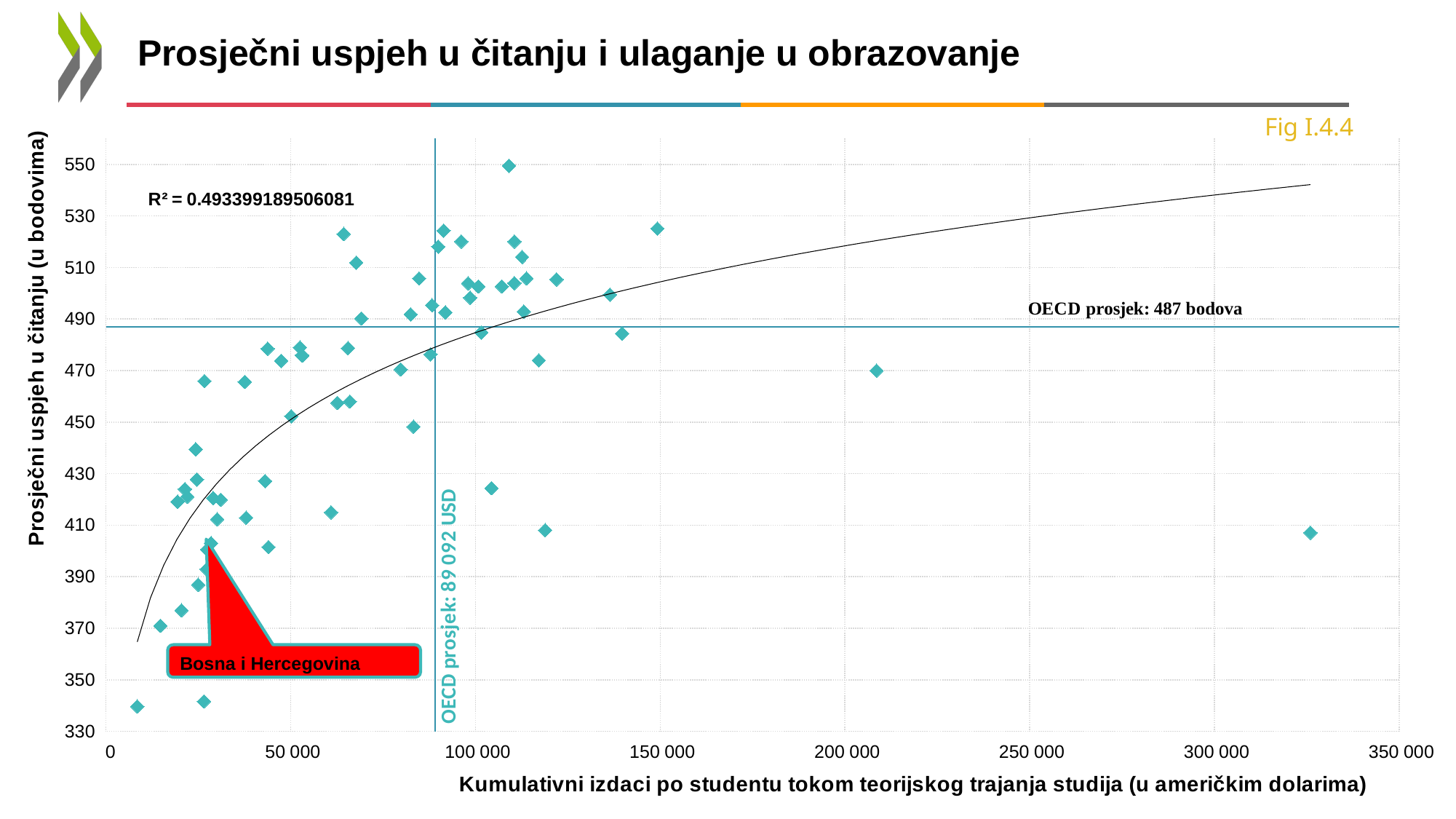
What is the OECD average reading score marked by the horizontal line? 487 bodova According to the trend line, does average reading performance rise or fall as cumulative spending per student increases? rise Is the reading score for Bosna i Hercegovina greater or less than the OECD average of 487? less Is the highest plotted reading score greater or less than 530? greater Is the cumulative spending per student for Bosna i Hercegovina greater or less than 50 000? less What R² value is printed on the chart? 0.493399189506081 What figure number is shown on the slide? Fig I.4.4 What is the OECD average cumulative spending per student marked by the vertical line? 89 092 USD Which country is explicitly labeled on the chart? Bosna i Hercegovina What kind of chart is shown on the slide? scatter chart